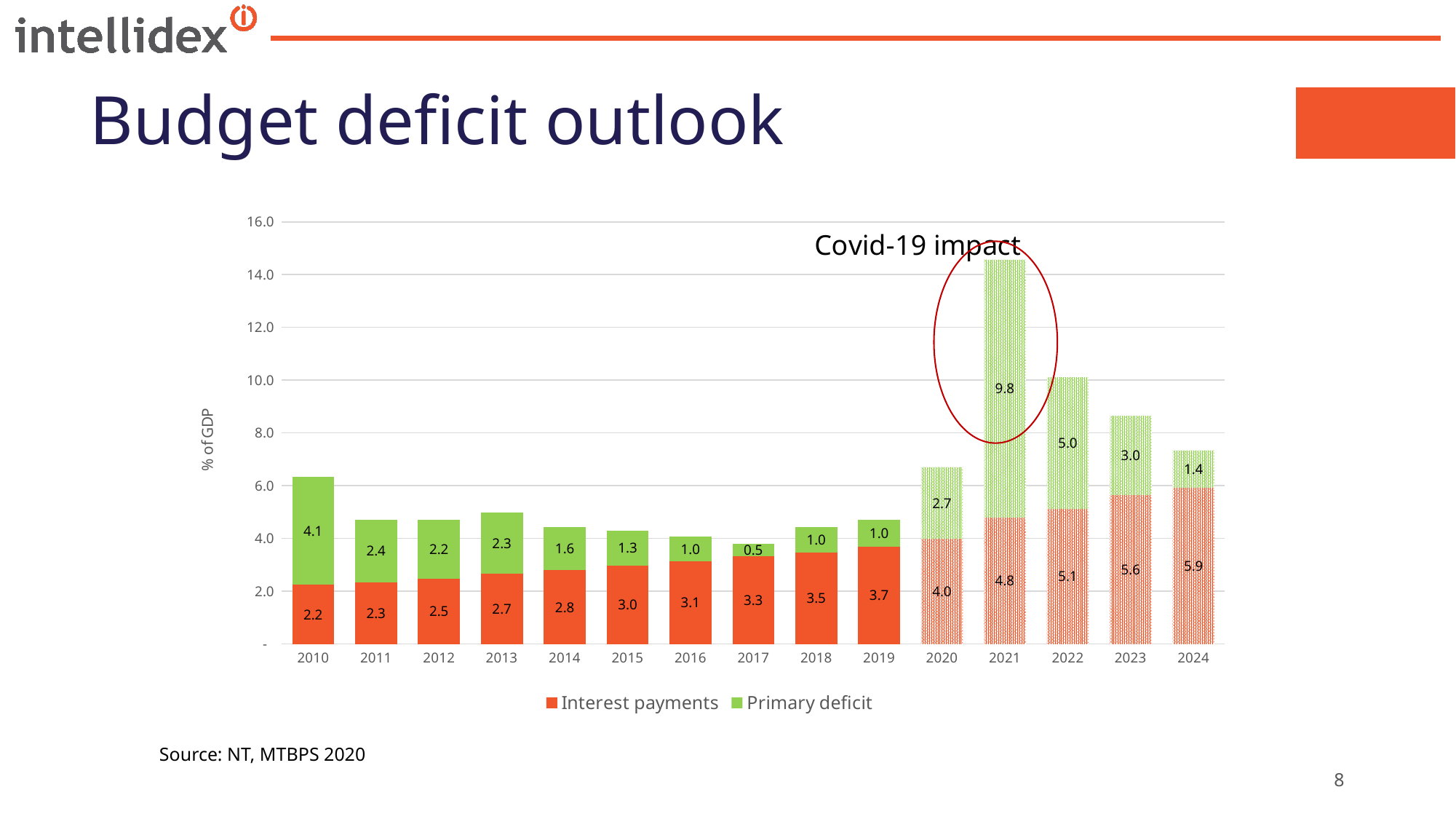
What is the value of Interest payments for 2019? 3.7 Which is larger, the Primary deficit for 2010 or for 2022? 2022 What is the total of the stacked bar for 2021? 14.6 What kind of chart is shown on the slide? Stacked bar chart How many years are shown on the x axis? 15 Which year has the highest Primary deficit value? 2021 What is the difference between the Interest payments values for 2024 and 2010? 3.7 Do the Interest payments values rise or fall from 2010 to 2024? Rise What is the value of Primary deficit for 2017? 0.5 Which year has the lowest Interest payments value? 2010 What is the value of Primary deficit for 2021? 9.8 How many series does the legend list? 2